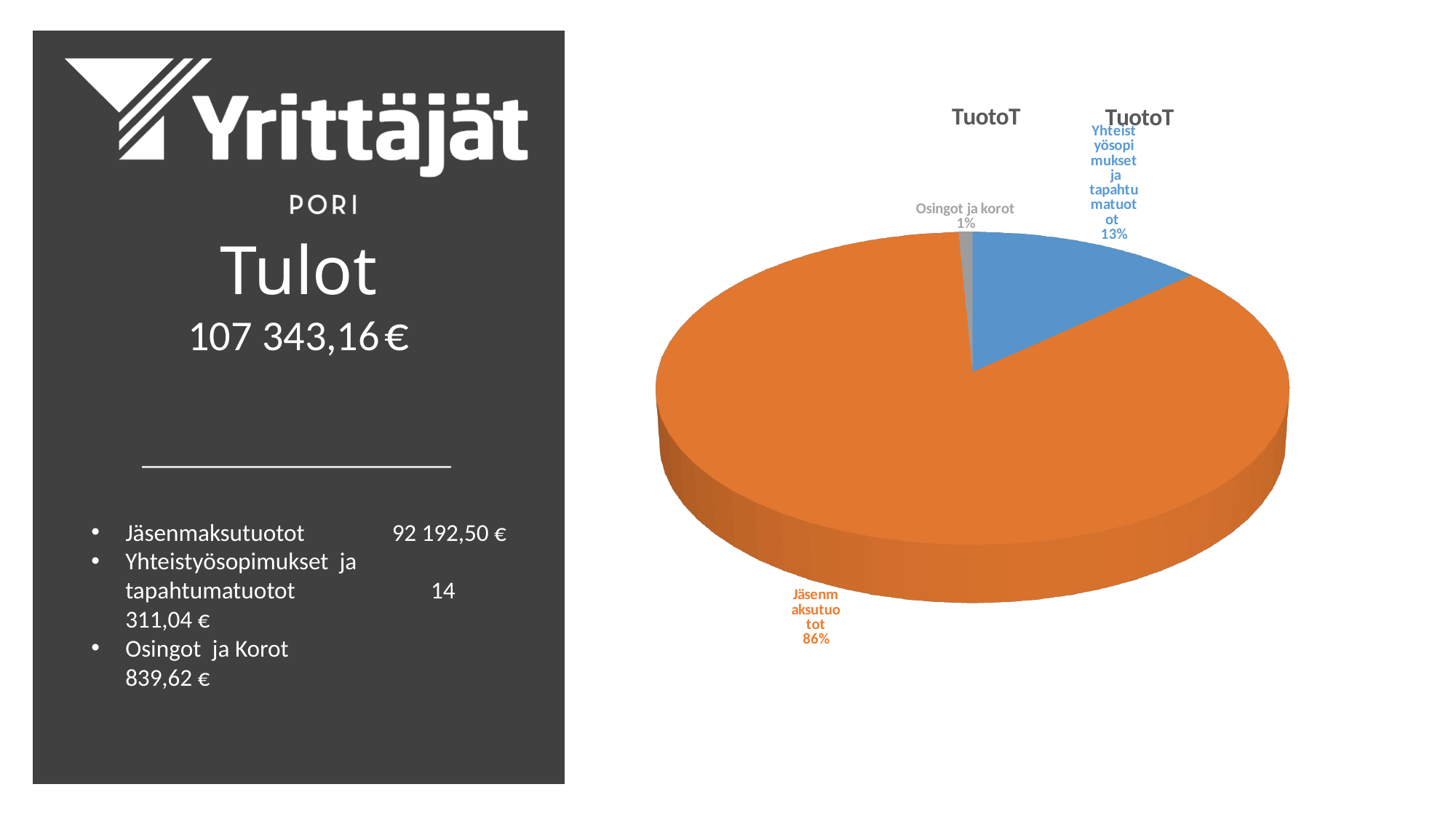
Which slice of the pie is the smallest? Osingot ja korot What kind of chart is shown on the slide? pie chart Which slice of the pie is the largest? Jäsenmaksutuotot Which is larger, the share for Yhteistyösopimukset ja tapahtumatuotot or the share for Osingot ja korot? Yhteistyösopimukset ja tapahtumatuotot What is the title of the pie chart? TuotoT What colour is the Jäsenmaksutuotot slice? orange What share of the pie does Osingot ja korot represent? 1% What share of the pie does Yhteistyösopimukset ja tapahtumatuotot represent? 13% How many slices does the pie chart have? 3 What is the difference in percentage points between the Jäsenmaksutuotot share and the Yhteistyösopimukset ja tapahtumatuotot share? 73 What share of the pie does Jäsenmaksutuotot represent? 86%